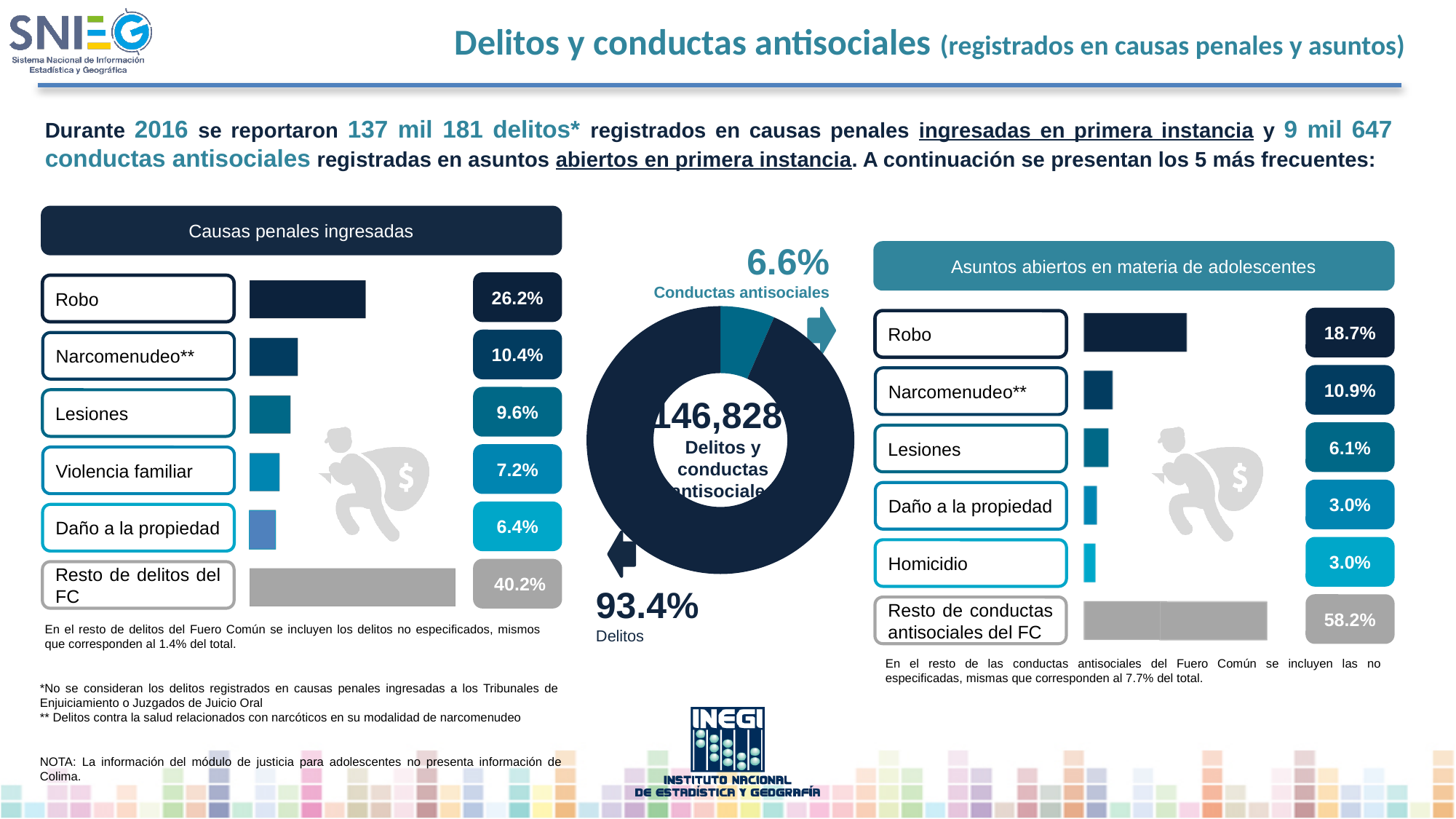
In the 'Causas penales ingresadas' chart, what percentage is shown for Violencia familiar? 7.2% In the 'Causas penales ingresadas' chart, what percentage is shown for Robo? 26.2% In the center donut chart, what share of the total corresponds to Conductas antisociales? 6.6% In the 'Asuntos abiertos en materia de adolescentes' chart, what percentage is shown for Resto de conductas antisociales del FC? 58.2% Which is larger: the percentage for Lesiones in the 'Causas penales ingresadas' chart or the percentage for Lesiones in the 'Asuntos abiertos en materia de adolescentes' chart? Causas penales ingresadas (9.6%) In the 'Asuntos abiertos en materia de adolescentes' chart, what percentage is shown for Narcomenudeo**? 10.9% In the center donut chart, what share of the total corresponds to Delitos? 93.4% In the 'Asuntos abiertos en materia de adolescentes' chart, what is the difference between the percentages for Robo and Lesiones? 12.6% In the 'Causas penales ingresadas' chart, which of the five named crime categories has the lowest percentage? Daño a la propiedad In the 'Asuntos abiertos en materia de adolescentes' chart, which category has the highest percentage? Resto de conductas antisociales del FC In the 'Causas penales ingresadas' chart, what is the difference between the percentages for Robo and Narcomenudeo**? 15.8% What kind of chart is the one in the center of the slide showing Delitos and Conductas antisociales? Donut (pie) chart